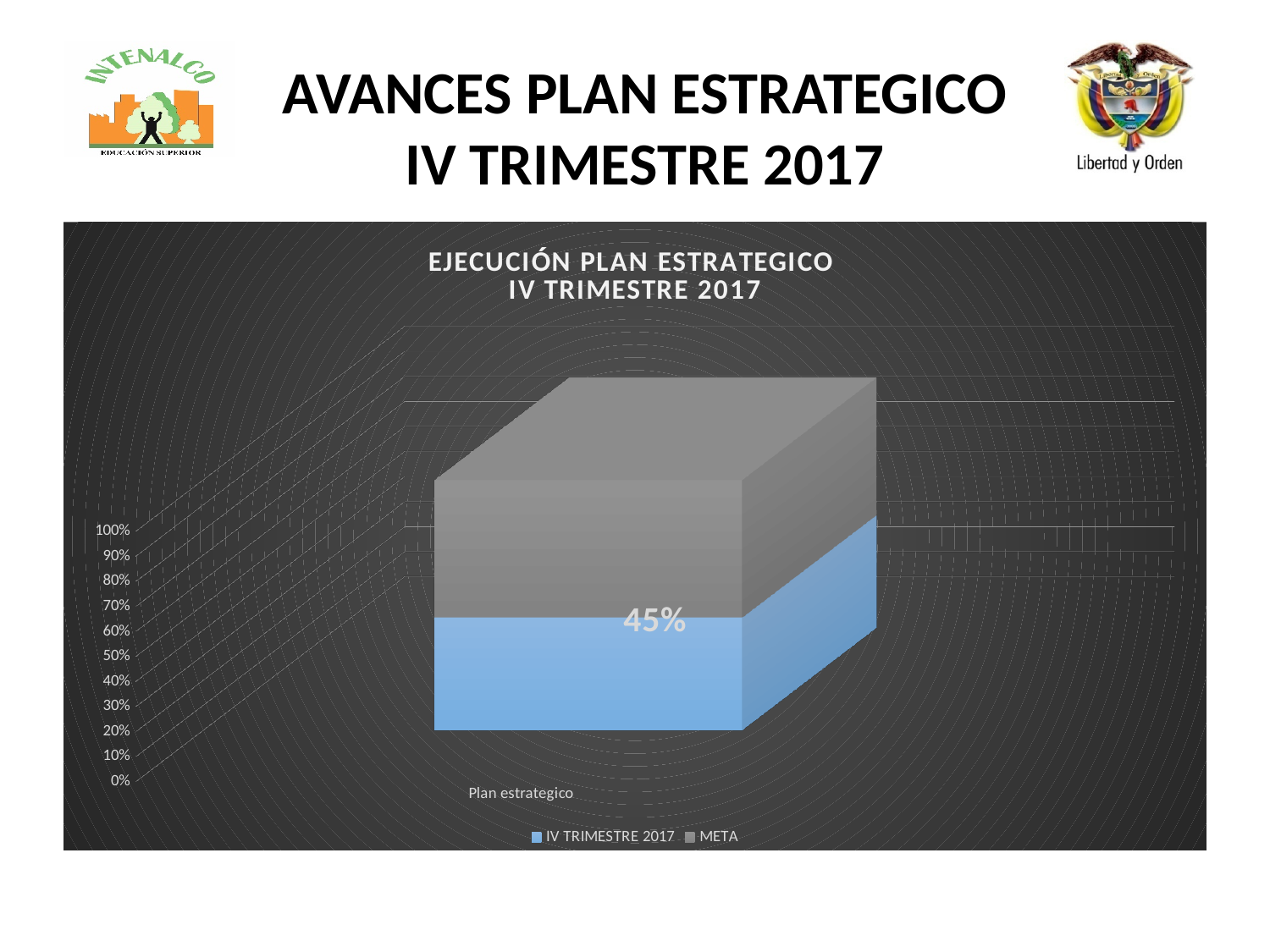
What is the highest value shown on the y axis? 100% Which series is shown in blue in the legend? IV TRIMESTRE 2017 How many series does the legend list? 2 What value is shown for IV TRIMESTRE 2017 in the Plan estrategico bar? 45% What is the name of the category shown on the x axis? Plan estrategico What is the title of the chart? EJECUCIÓN PLAN ESTRATEGICO IV TRIMESTRE 2017 How many categories are shown on the x axis? 1 What type of chart is shown on the slide? bar chart Is the value for IV TRIMESTRE 2017 greater or less than 50%? less